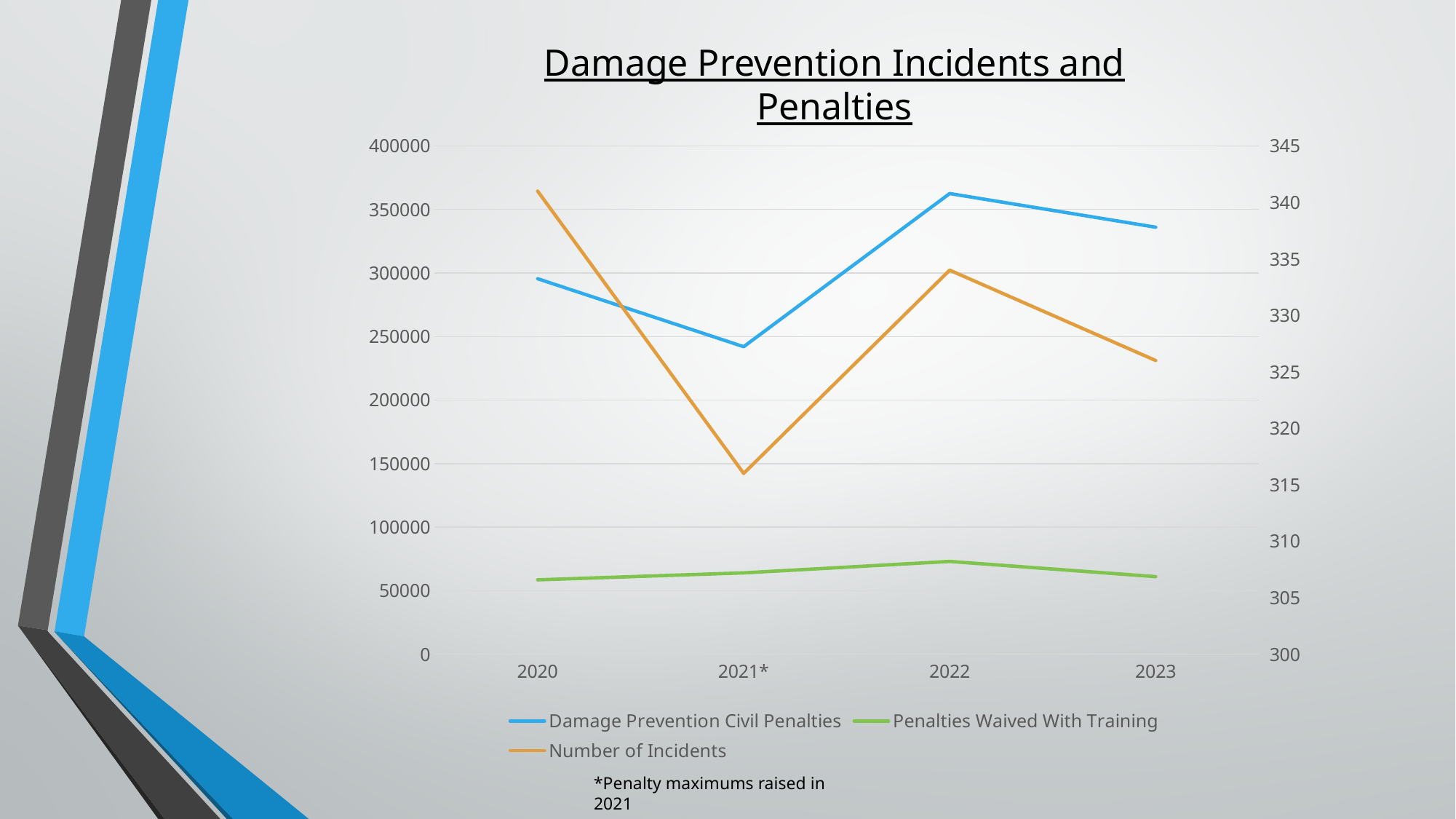
How many years are shown on the x axis? 4 Is the value for Damage Prevention Civil Penalties in 2022 greater or less than 350000? greater What is the title of the chart? Damage Prevention Incidents and Penalties In which year is Number of Incidents highest? 2020 In which year is Damage Prevention Civil Penalties lowest? 2021* Which is larger for Damage Prevention Civil Penalties: 2020 or 2023? 2023 Is the value for Damage Prevention Civil Penalties in 2021* greater or less than 250000? less Does Penalties Waived With Training rise or fall from 2020 to 2022? rise What kind of chart is shown on the slide? line chart How many series does the legend list? 3 In which year is Damage Prevention Civil Penalties highest? 2022 In which year is Number of Incidents lowest? 2021*